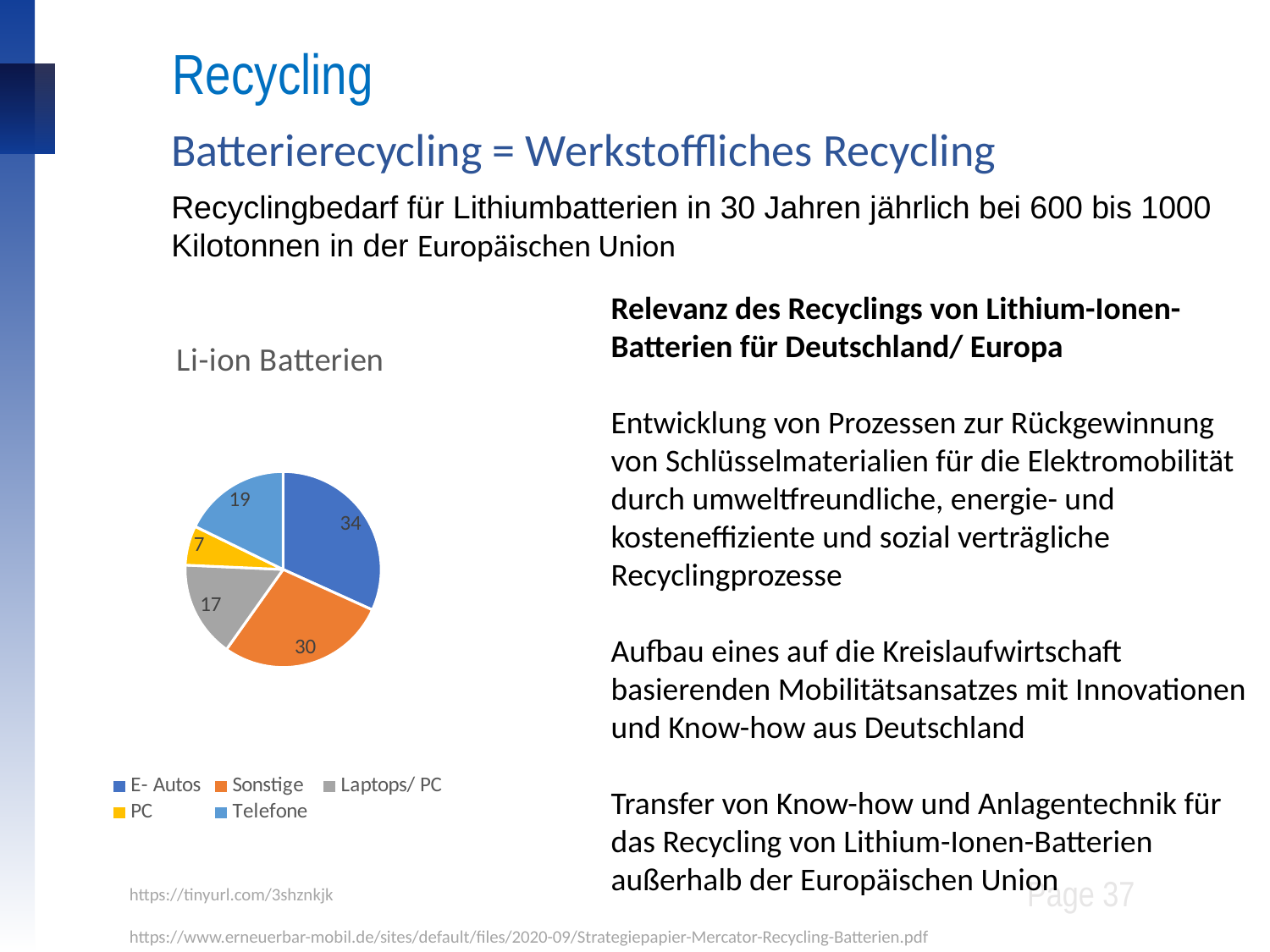
What is the title of the chart? Li-ion Batterien How many entries does the legend list? 5 What is the difference between the values for E- Autos and Sonstige? 4 What is the value for E- Autos in the pie chart? 34 What is the value for Telefone in the pie chart? 19 Which is larger, the value for Telefone or the value for Laptops/ PC? Telefone How many categories does the pie chart have? 5 Which category has the smallest slice in the pie chart? PC What is the value for Sonstige in the pie chart? 30 What type of chart is shown on the slide? pie chart What is the value for Laptops/ PC in the pie chart? 17 Which category has the largest slice in the pie chart? E- Autos